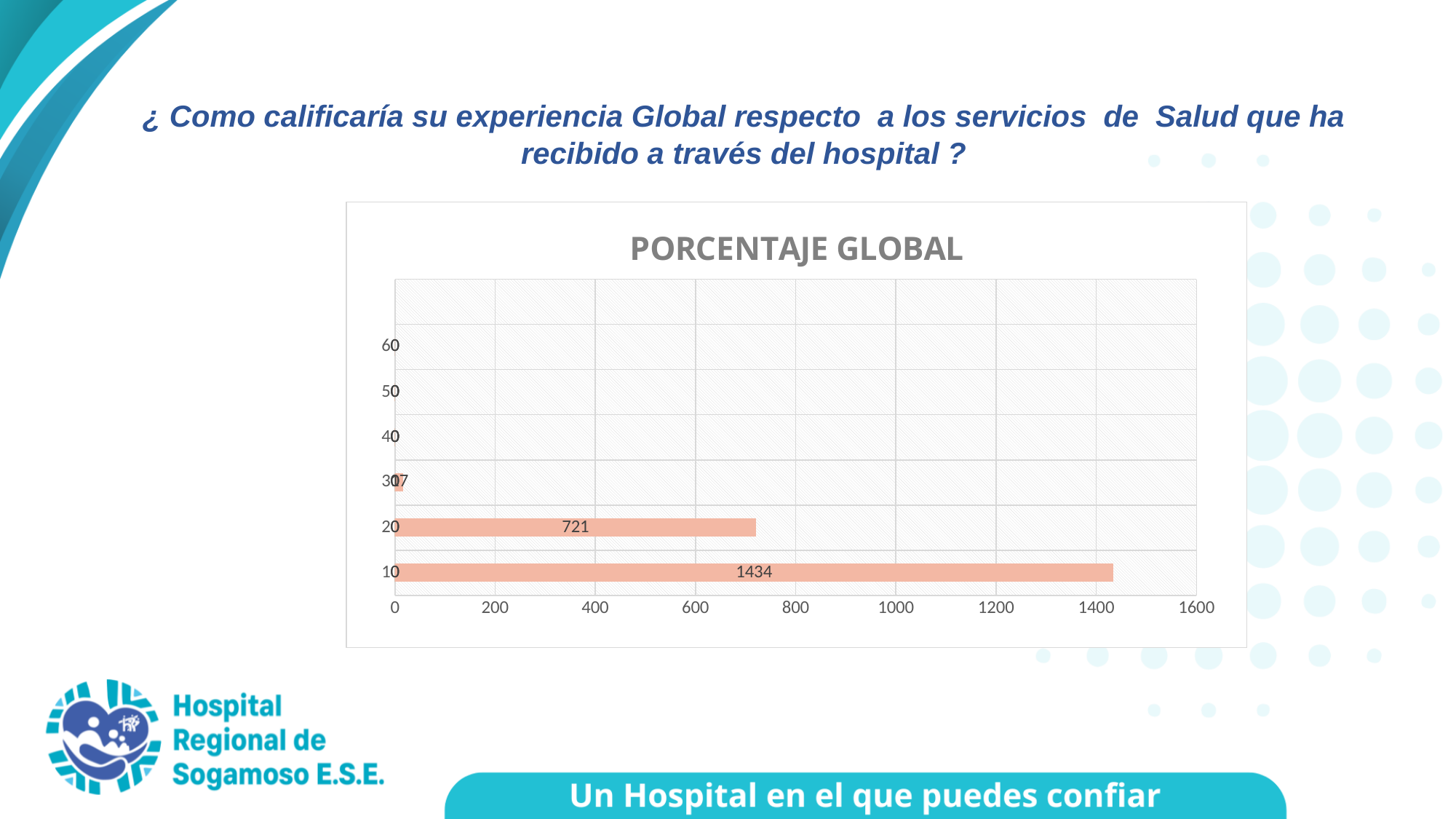
What is the title of the chart? PORCENTAJE GLOBAL What is the difference between the values for category 10 and category 20? 713 Is the value for category 20 greater or less than 800? less Which has the larger value, category 10 or category 20? 10 How many categories are shown on the vertical axis of the chart? 6 What is the maximum value shown on the horizontal axis of the chart? 1600 What is the value for category 10 in the PORCENTAJE GLOBAL chart? 1434 Which category has the highest value in the PORCENTAJE GLOBAL chart? 10 Is the value for category 10 greater or less than 1400? greater What is the value for category 20 in the PORCENTAJE GLOBAL chart? 721 Is the value for category 30 greater or less than 200? less What kind of chart is shown on the slide? bar chart